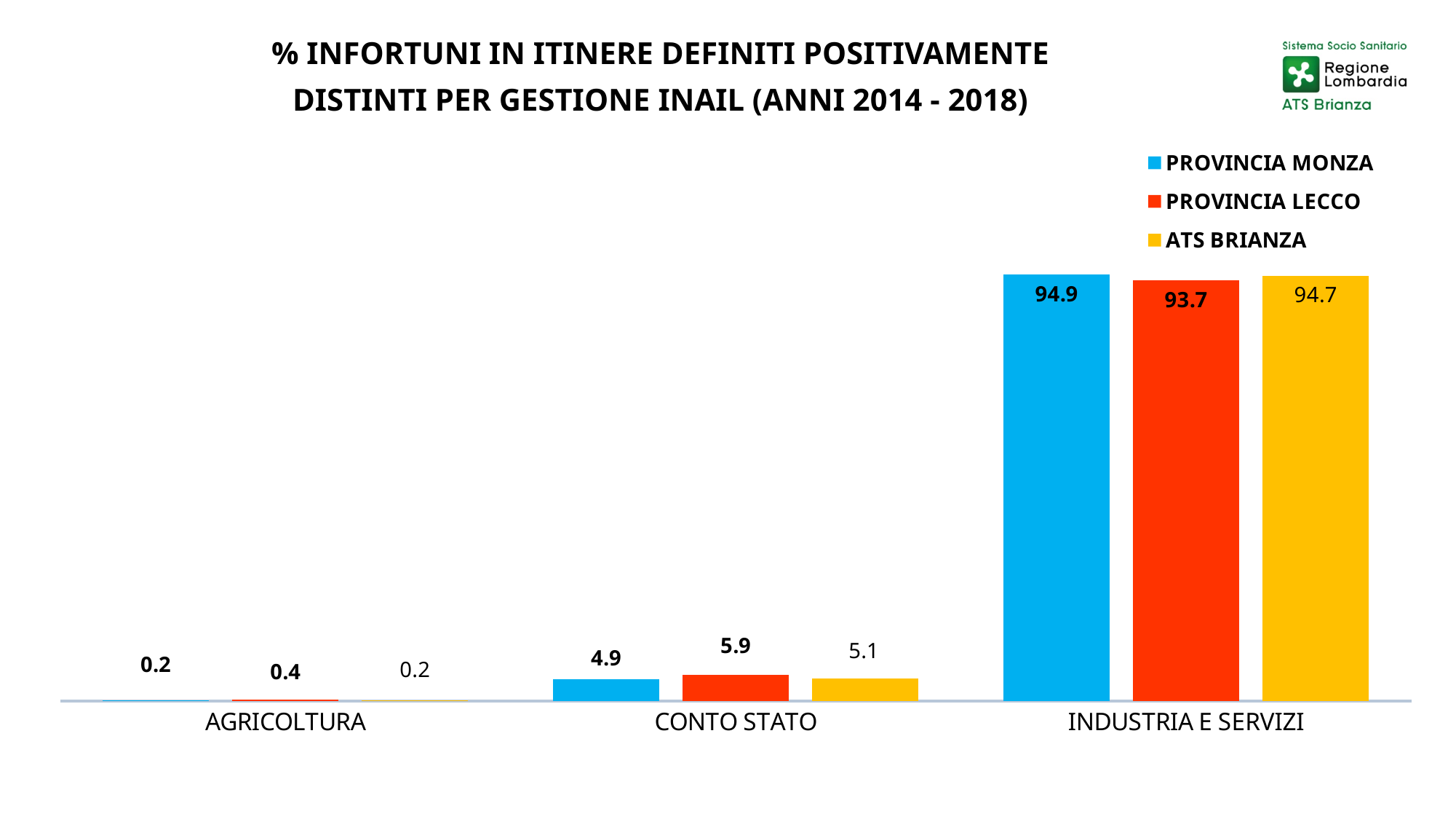
What is the value for PROVINCIA LECCO in the AGRICOLTURA category? 0.4 What kind of chart is shown on the slide? Bar chart What is the value for PROVINCIA MONZA in the INDUSTRIA E SERVIZI category? 94.9 What is the difference between the PROVINCIA MONZA and PROVINCIA LECCO values in the INDUSTRIA E SERVIZI category? 1.2 How many series does the legend list? 3 Which category has the highest value for ATS BRIANZA? INDUSTRIA E SERVIZI In the CONTO STATO category, which series has the larger value: PROVINCIA MONZA or ATS BRIANZA? ATS BRIANZA What is the value for ATS BRIANZA in the AGRICOLTURA category? 0.2 How many categories are shown on the x axis? 3 What is the difference between the PROVINCIA LECCO and PROVINCIA MONZA values in the CONTO STATO category? 1.0 Which category has the lowest value for PROVINCIA MONZA? AGRICOLTURA What is the value for PROVINCIA LECCO in the CONTO STATO category? 5.9